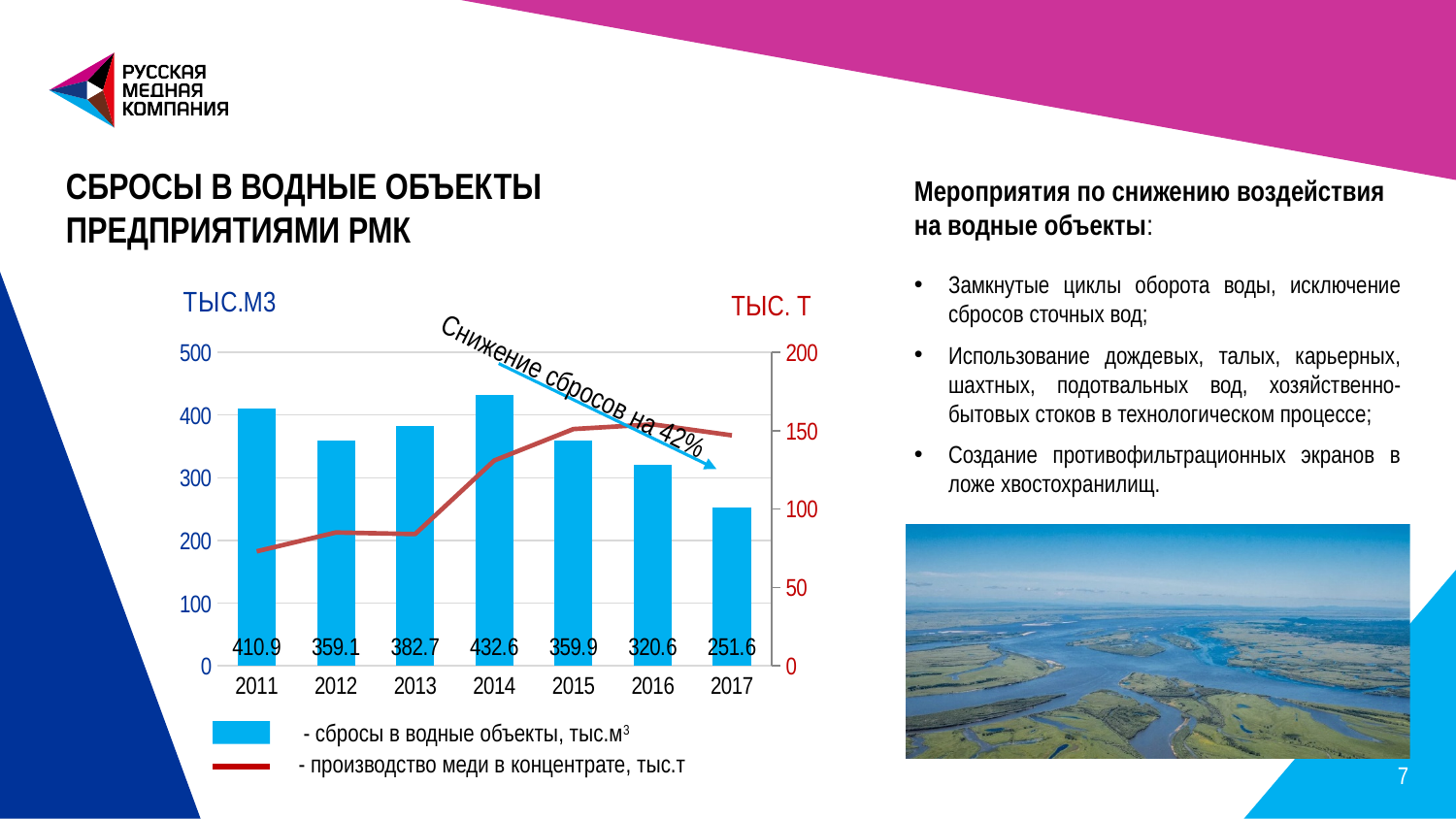
What is the value of discharges into water bodies (тыс.м3) for 2014? 432.6 What is the value of discharges into water bodies (тыс.м3) for 2017? 251.6 Which year has the lowest value of discharges into water bodies? 2017 Is the value of copper production in concentrate (тыс. т) for 2016 greater or less than 100? greater How many years are shown on the x axis of the chart? 7 Which year has the highest value of discharges into water bodies? 2014 How many series does the chart legend list? 2 According to the annotation on the chart, by what percentage did discharges decrease? 42% What is the difference between the discharges into water bodies in 2011 and 2017? 159.3 Is the value of copper production in concentrate (тыс. т) for 2011 greater or less than 100? less Which year has a larger value of discharges into water bodies, 2013 or 2016? 2013 What is the value of discharges into water bodies (тыс.м3) for 2012? 359.1